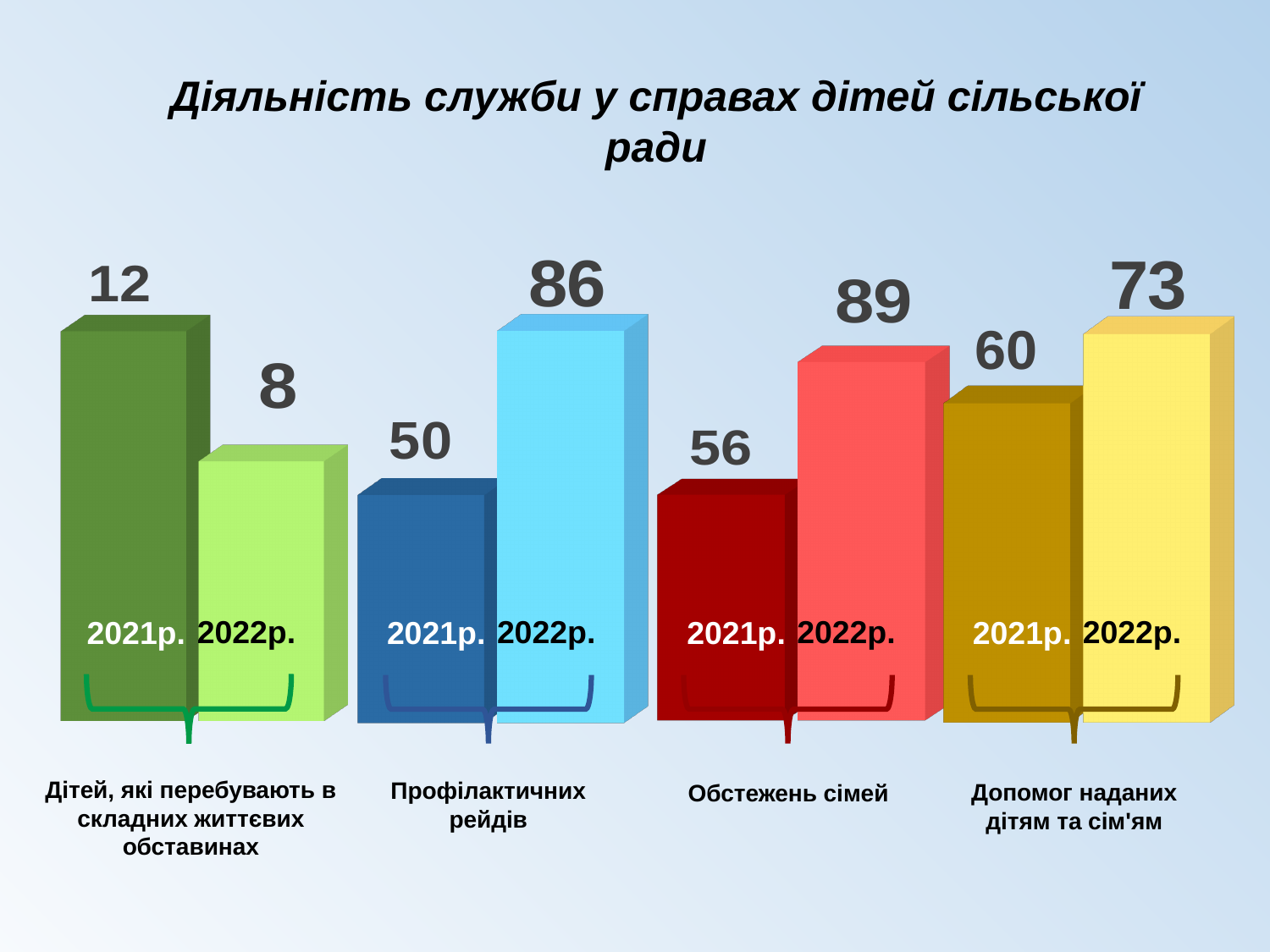
What is the title of the chart? Діяльність служби у справах дітей сільської ради What is the value for 2021р. in the category "Профілактичних рейдів"? 50 Which category has the lowest 2021р. value? Дітей, які перебувають в складних життєвих обставинах What is the value for 2022р. in the category "Обстежень сімей"? 89 What is the value for 2021р. in the category "Допомог наданих дітям та сім'ям"? 60 Which is larger for "Дітей, які перебувають в складних життєвих обставинах": the 2021р. value or the 2022р. value? 2021р. What is the difference between the 2022р. and 2021р. values for "Допомог наданих дітям та сім'ям"? 13 What is the value for 2022р. in the category "Дітей, які перебувають в складних життєвих обставинах"? 8 How many categories are shown on the chart? 4 Which category has the highest 2022р. value? Обстежень сімей What kind of chart is shown on the slide? Bar chart What is the difference between the 2022р. and 2021р. values for "Профілактичних рейдів"? 36